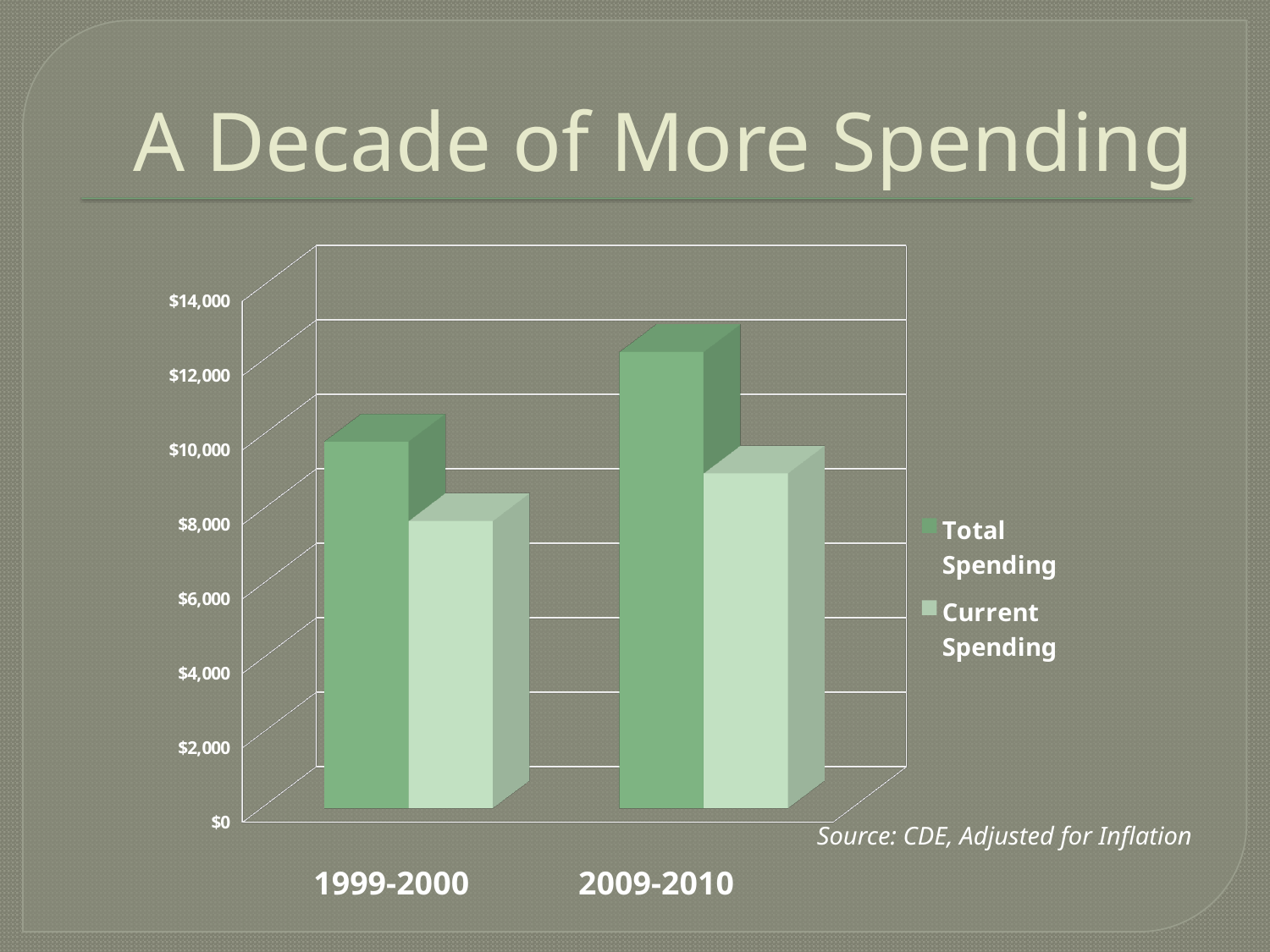
How many series does the legend list? 2 Do the spending values rise or fall from 1999-2000 to 2009-2010? Rise Which series and category has the tallest bar? Total Spending, 2009-2010 Is the value for Current Spending in 1999-2000 greater or less than $10,000? less How many categories are shown on the x axis? 2 In 2009-2010, which is larger, Total Spending or Current Spending? Total Spending Is Current Spending higher in 1999-2000 or in 2009-2010? 2009-2010 Is the value for Current Spending in 2009-2010 greater or less than $8,000? greater Is the value for Total Spending in 2009-2010 greater or less than $10,000? greater Is Total Spending higher in 1999-2000 or in 2009-2010? 2009-2010 What kind of chart is shown on the slide? Bar chart Which series and category has the shortest bar? Current Spending, 1999-2000